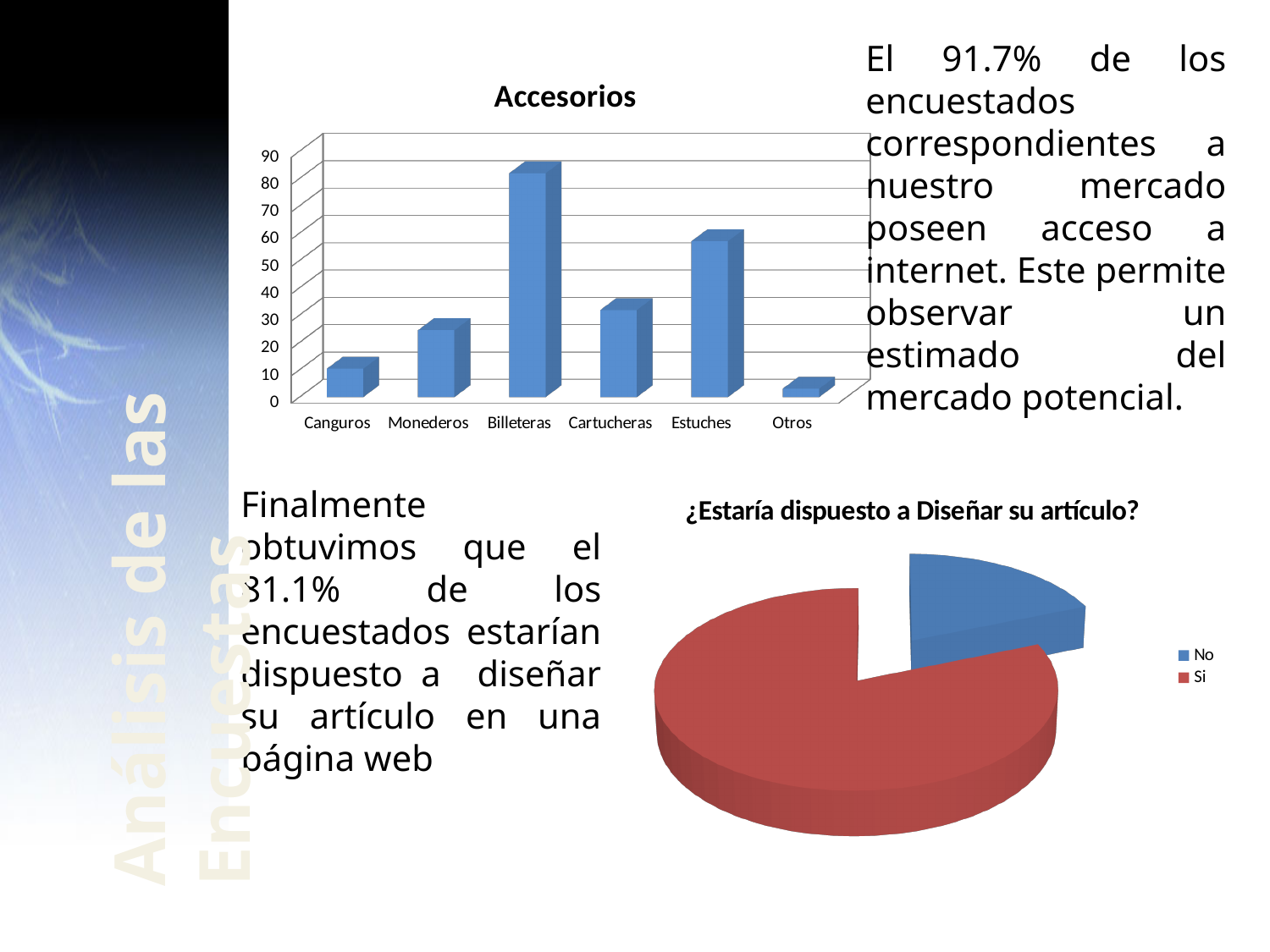
In the "Accesorios" chart, which is larger, Monederos or Canguros? Monederos What kind of chart is the "Accesorios" chart? bar chart In the "Accesorios" chart, is the value for Estuches greater or less than 50? greater How many categories are shown on the x axis of the "Accesorios" chart? 6 In the "Accesorios" chart, is the value for Billeteras greater or less than 70? greater In the "Accesorios" chart, which category has the highest value? Billeteras In the "¿Estaría dispuesto a Diseñar su artículo?" pie chart, which slice is larger, Si or No? Si What kind of chart is the "¿Estaría dispuesto a Diseñar su artículo?" chart? pie chart In the "Accesorios" chart, which category has the lowest value? Otros In the "Accesorios" chart, which is larger, Estuches or Cartucheras? Estuches In the "Accesorios" chart, is the value for Canguros greater or less than 20? less How many entries does the legend of the "¿Estaría dispuesto a Diseñar su artículo?" chart list? 2